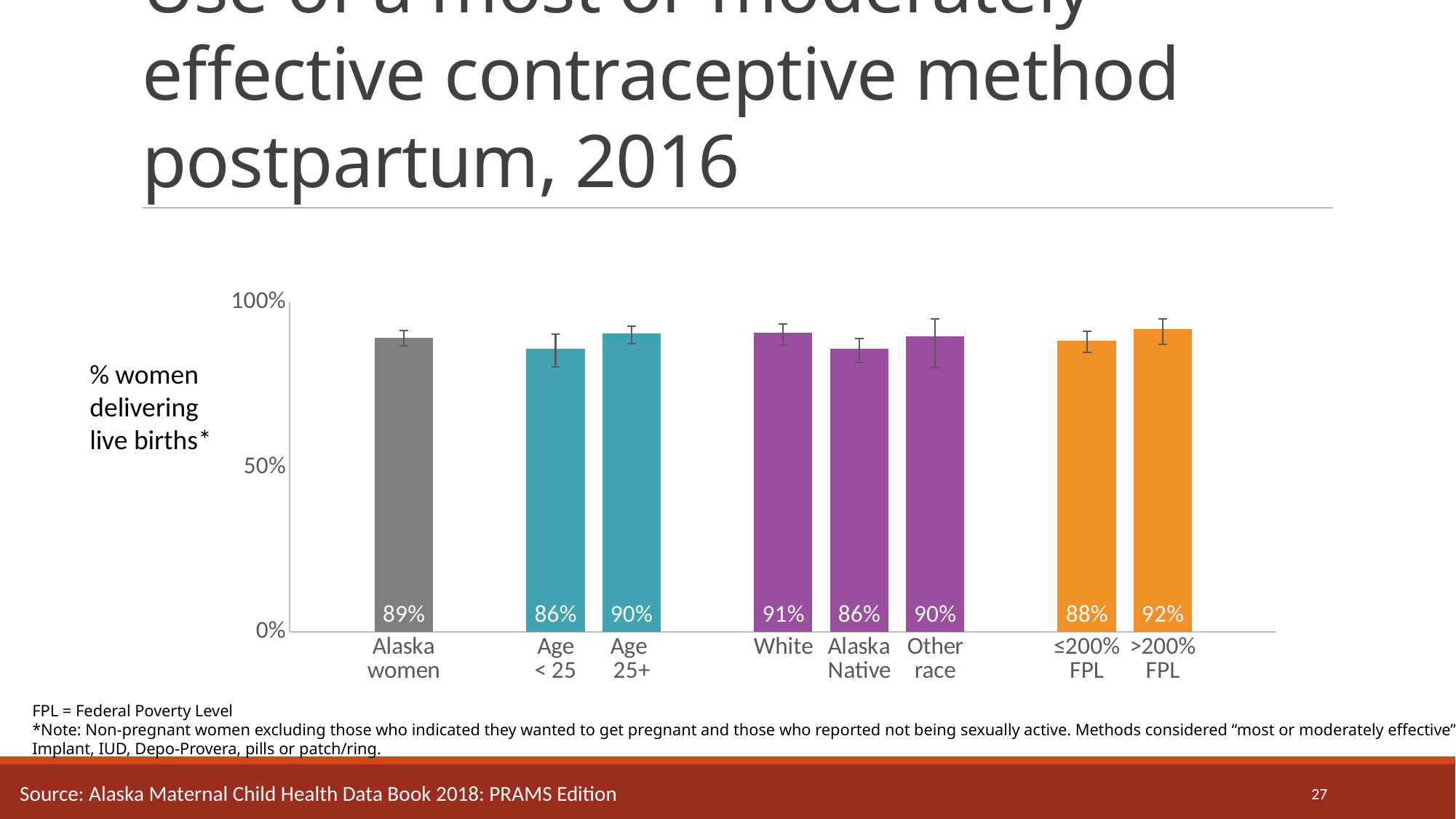
What is the value for >200% FPL? 92% What is the value for Age < 25? 86% How many bars are shown on the chart? 8 What is the lowest value shown on the chart? 86% What is the value for White? 91% Which category has the highest value? >200% FPL What is the difference between the values for White and Alaska Native? 5% What is the difference between the values for >200% FPL and ≤200% FPL? 4% Is the value for Other race greater or less than 50%? greater Which is larger, the value for Age 25+ or the value for Age < 25? Age 25+ What is the value for Alaska women? 89% What kind of chart is shown on the slide? bar chart